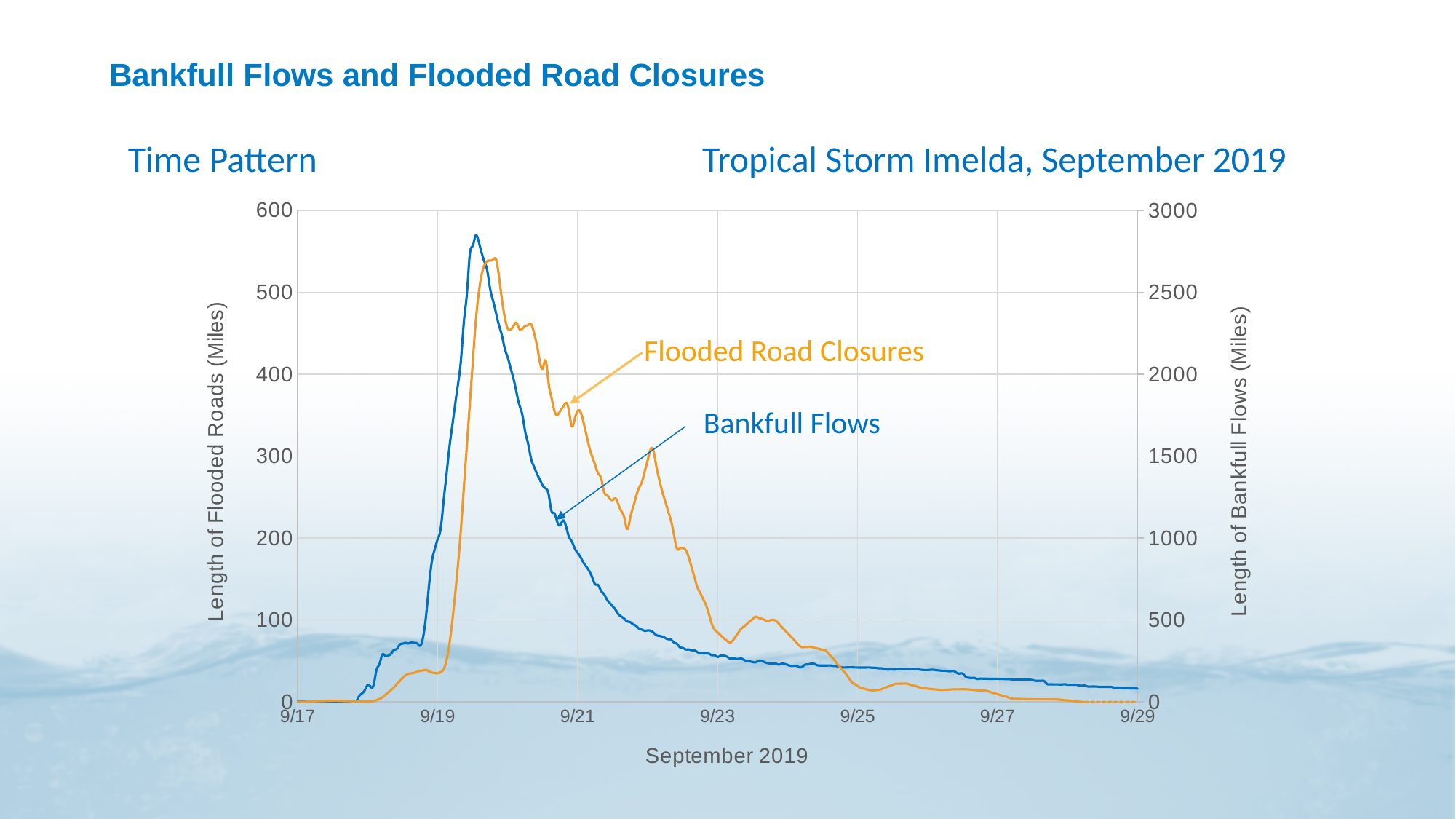
Is the peak value of Flooded Road Closures greater or less than 500 on the left axis? greater Do the Bankfull Flows values rise or fall between 9/17 and 9/19? rise Is the value for Bankfull Flows on 9/27 greater or less than 500 on the right axis? less Is the value for Flooded Road Closures on 9/23 greater or less than 200 on the left axis? less What is the label of the left vertical axis? Length of Flooded Roads (Miles) Do the Flooded Road Closures values rise or fall between 9/21 and 9/29? fall What kind of chart is shown on the slide? Line chart How many data series are plotted on the chart? 2